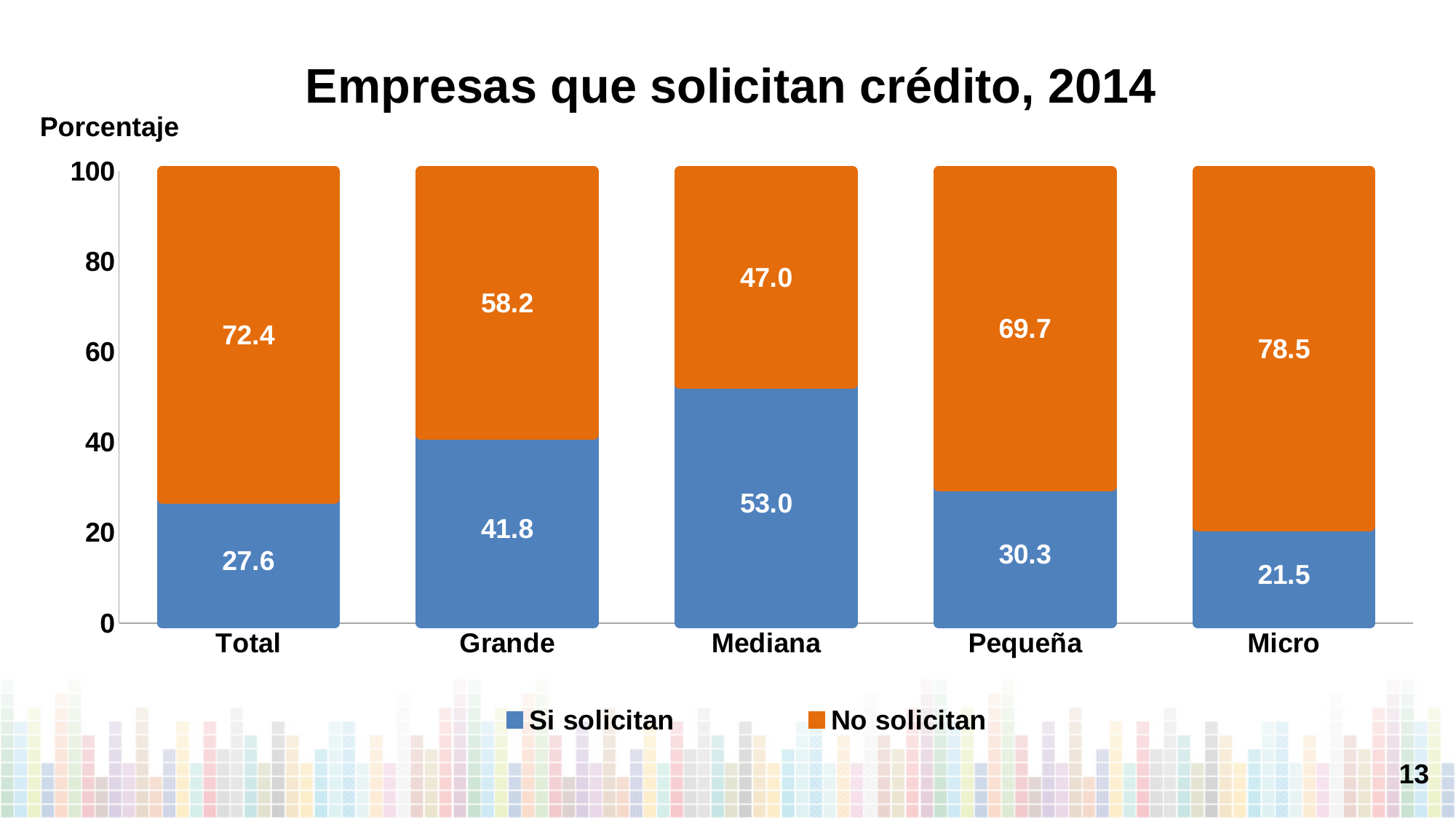
What is the 'No solicitan' value for Micro? 78.5 What kind of chart is shown on the slide? Stacked bar chart Which is larger, the 'Si solicitan' value for Grande or for Pequeña? Grande How many series does the legend list? 2 What is the total of the stacked bar for Grande? 100.0 Which category has the highest 'Si solicitan' value? Mediana Which category has the lowest 'Si solicitan' value? Micro How many categories are shown on the x axis? 5 What is the difference between the 'No solicitan' values for Micro and Mediana? 31.5 What is the title of the chart? Empresas que solicitan crédito, 2014 What is the 'Si solicitan' value for Total? 27.6 What is the 'Si solicitan' value for Mediana? 53.0